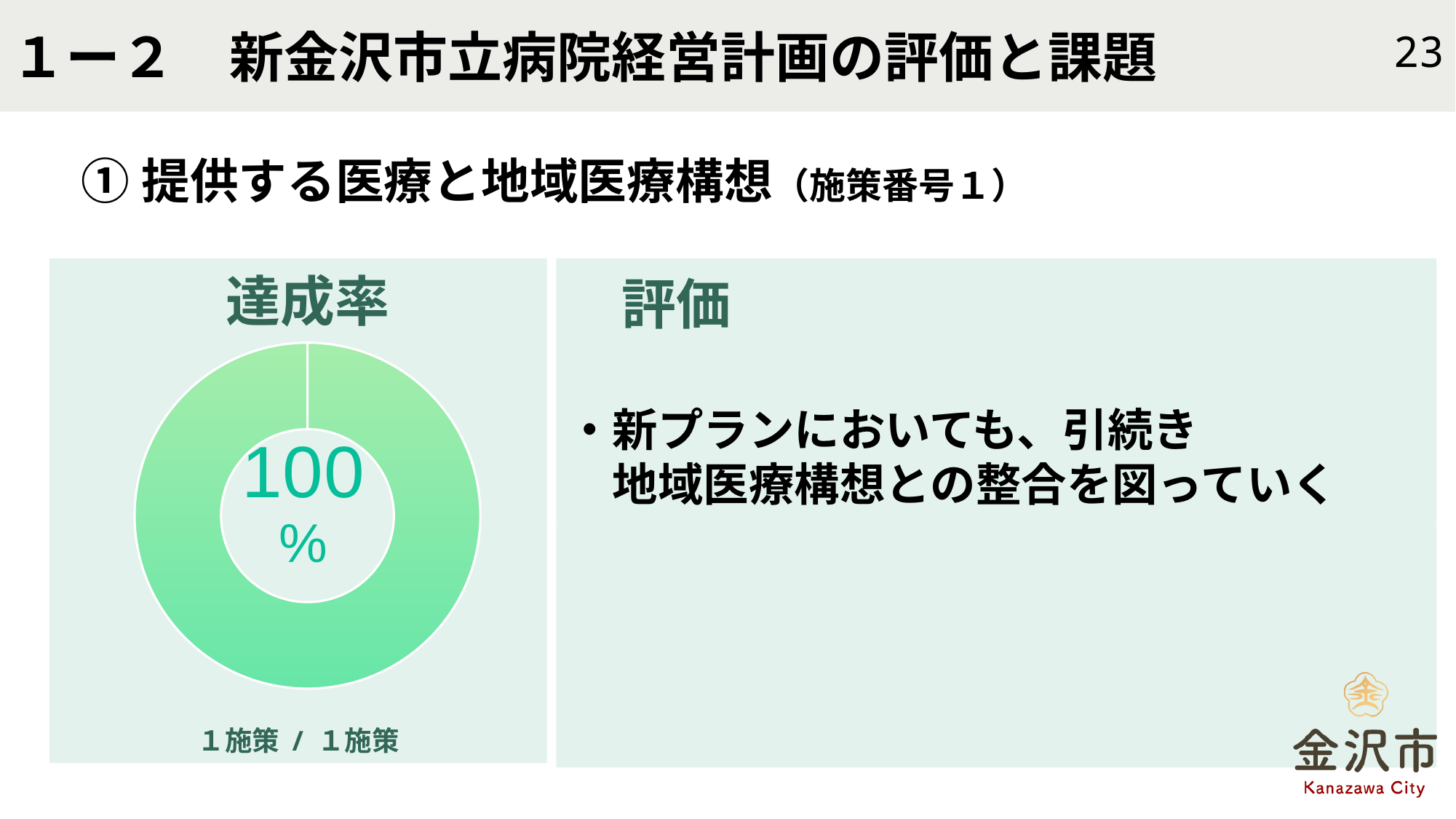
How many distinct slices are visible in the 達成率 donut chart? 1 How many measures (施策) in total does the 達成率 chart cover? 1 What share of the 達成率 donut chart is filled by the achieved portion? 100% According to the label below the 達成率 chart, how many measures were achieved out of how many? 1施策 / 1施策 What kind of chart is shown under 達成率? donut chart What colour is the ring of the 達成率 donut chart? green What is the title of the chart on the left side of the slide? 達成率 What percentage is displayed in the centre of the 達成率 chart? 100%